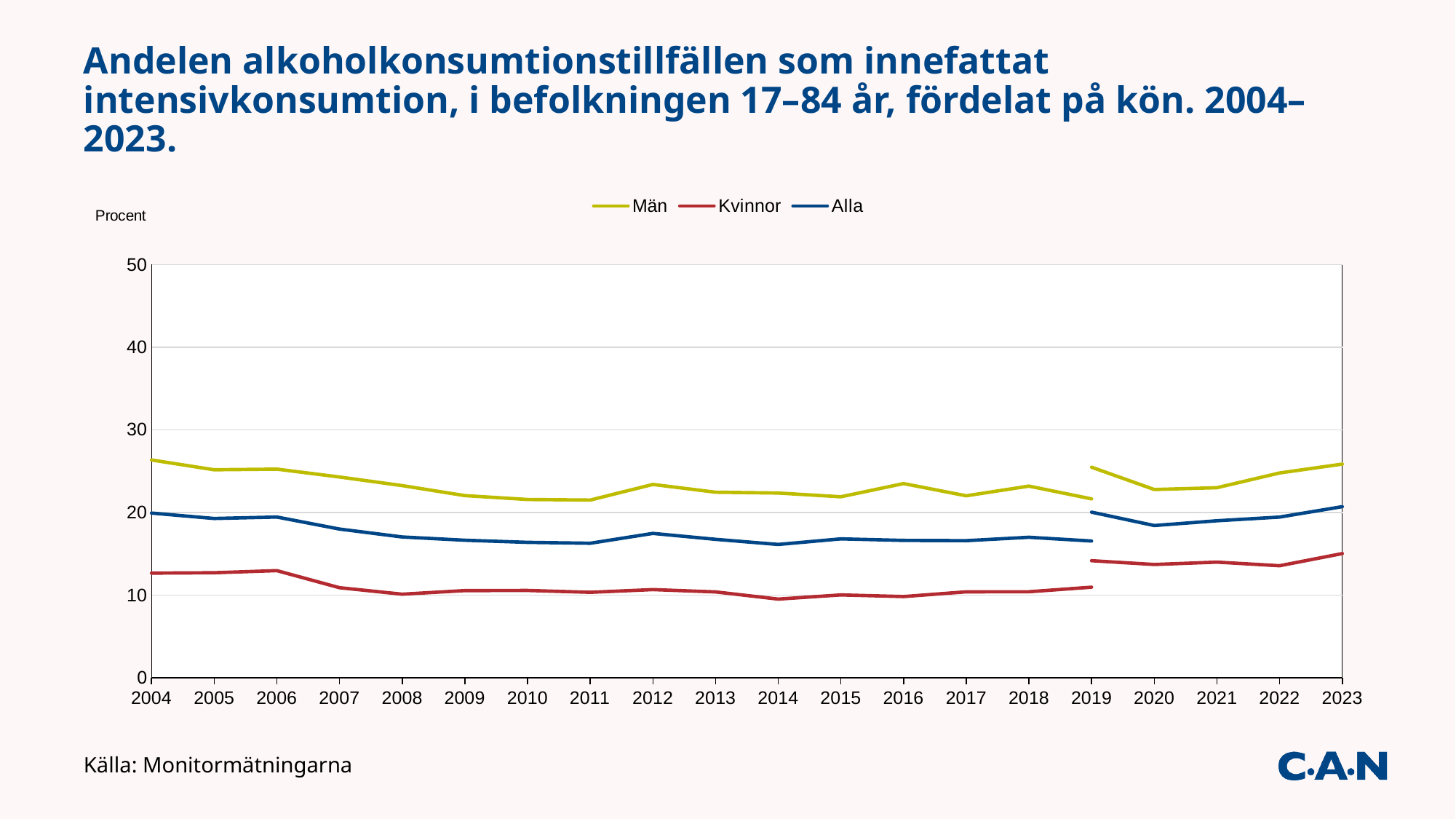
Is the value for Män in 2023 greater or less than 30? less What kind of chart is shown on the slide? line chart Does the Män line rise or fall from 2020 to 2023? rise What is the label on the y axis? Procent How many years are plotted along the x axis? 20 Which series has the highest values throughout the chart? Män How many series does the legend list? 3 Is the value for Kvinnor in 2023 greater or less than 10? greater Is the value for Män in 2004 greater or less than 20? greater Which series has the lowest values throughout the chart? Kvinnor Which is larger in 2010, the value for Män or the value for Kvinnor? Män